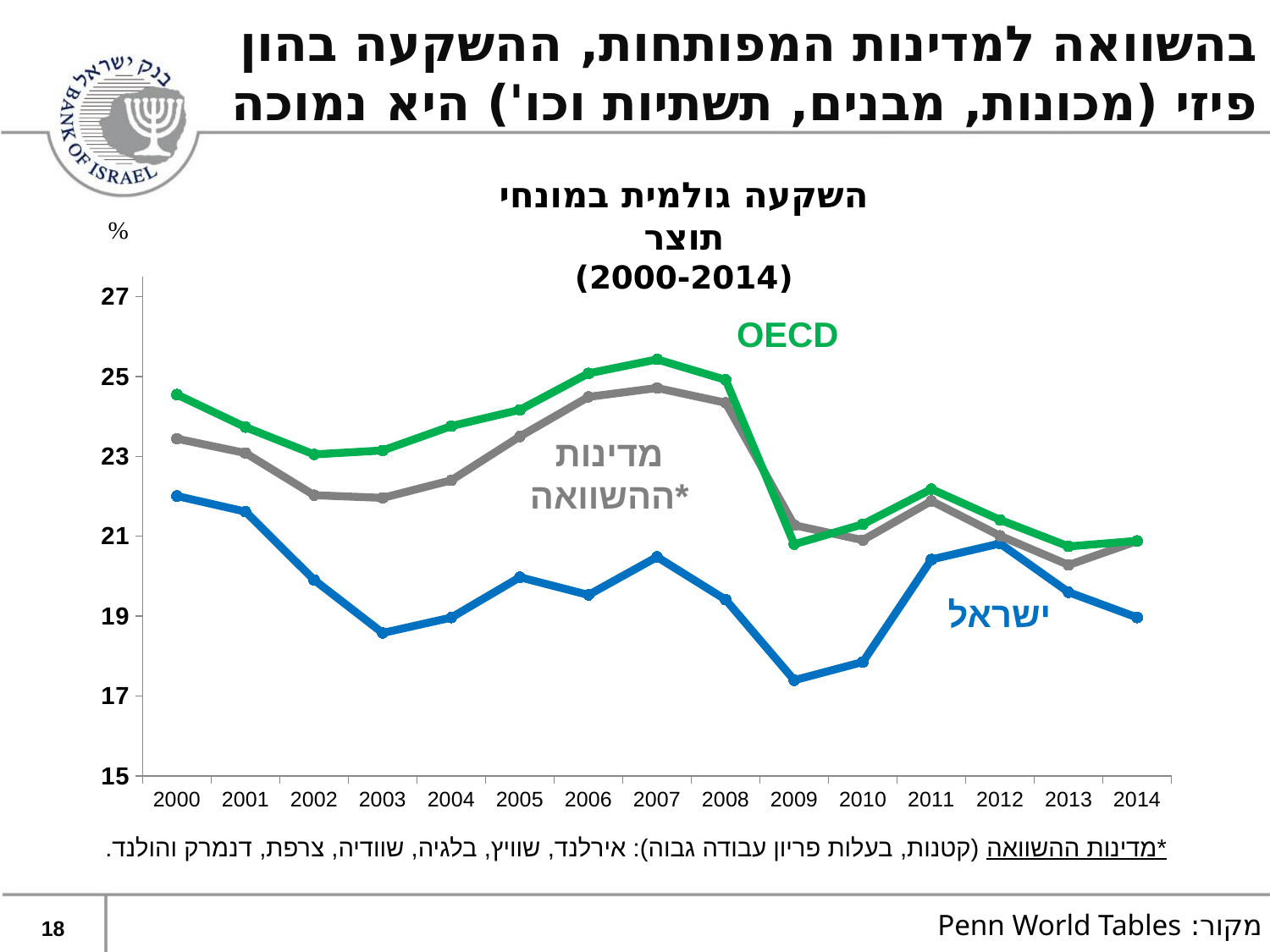
In 2010, which is larger: the value for ישראל or the value for OECD? OECD Is the value for OECD in 2007 greater or less than 23? greater What kind of chart is shown on the slide? line chart Does the ישראל series rise or fall from 2000 to 2003? fall How many years (data points per series) are plotted along the x axis? 15 Is the value for ישראל in 2009 greater or less than 19? less In 2000, which is larger: the value for OECD or the value for ישראל? OECD Which series has the highest value in 2007? OECD How many series are plotted on the chart? 3 Is the value for ישראל in 2014 greater or less than 21? less What is the source cited for the chart data? Penn World Tables In which year does the ישראל series reach its lowest value? 2009